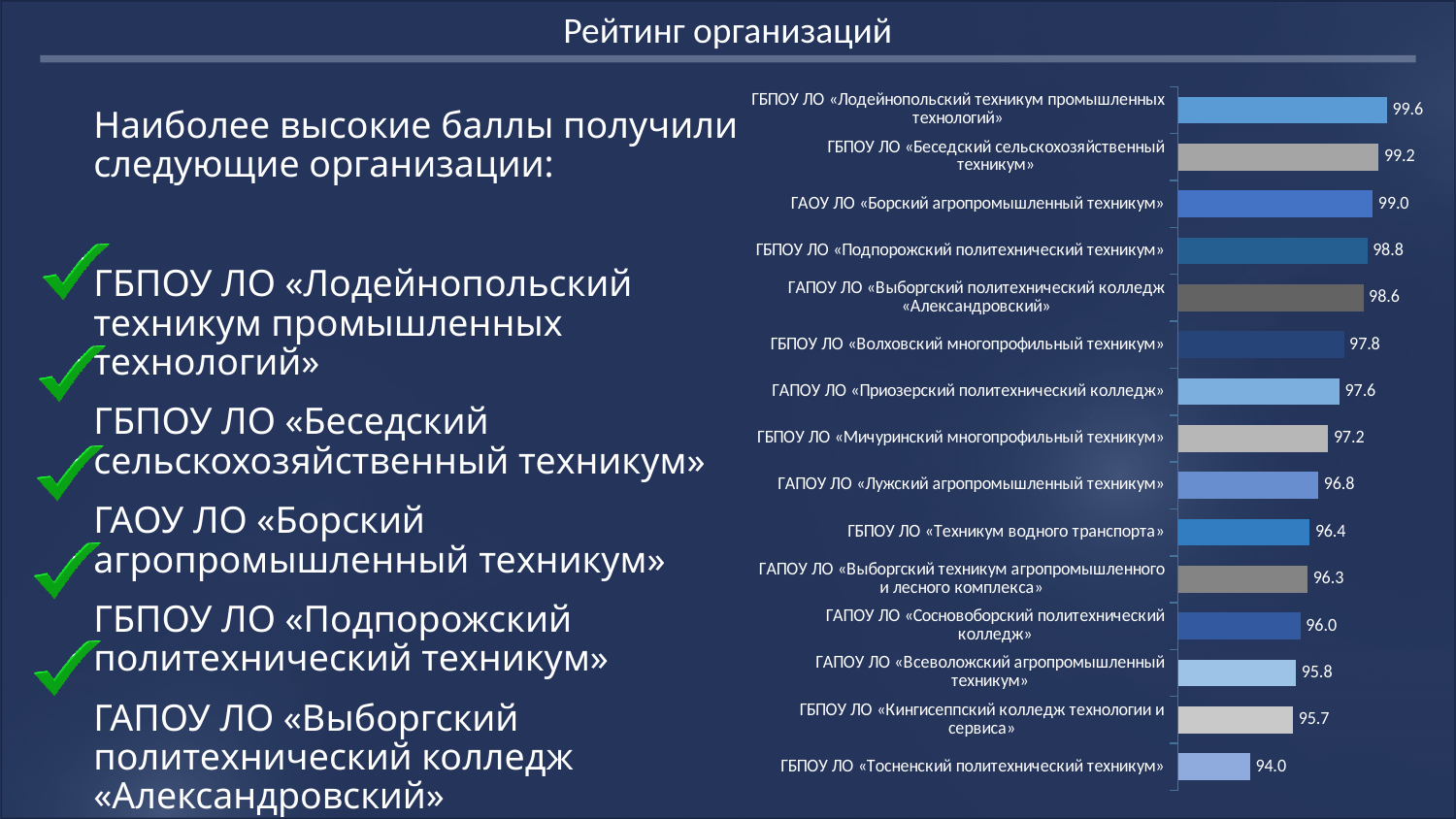
What is the value for ГБПОУ ЛО «Техникум водного транспорта»? 96.4 What type of chart is shown on the slide? bar chart Which has the larger value: ГБПОУ ЛО «Мичуринский многопрофильный техникум» or ГАПОУ ЛО «Сосновоборский политехнический колледж»? ГБПОУ ЛО «Мичуринский многопрофильный техникум» Which organisation has the lowest value in the chart? ГБПОУ ЛО «Тосненский политехнический техникум» What is the value for ГАПОУ ЛО «Приозерский политехнический колледж»? 97.6 What is the difference between the values for ГБПОУ ЛО «Беседский сельскохозяйственный техникум» and ГБПОУ ЛО «Подпорожский политехнический техникум»? 0.4 What is the value for ГБПОУ ЛО «Лодейнопольский техникум промышленных технологий»? 99.6 How many organisations are plotted in the chart? 15 What is the difference between the highest value (99.6) and the lowest value (94.0) in the chart? 5.6 What is the value for ГБПОУ ЛО «Кингисеппский колледж технологии и сервиса»? 95.7 What is the title of the slide containing the chart? Рейтинг организаций Which organisation has the highest value in the chart? ГБПОУ ЛО «Лодейнопольский техникум промышленных технологий»